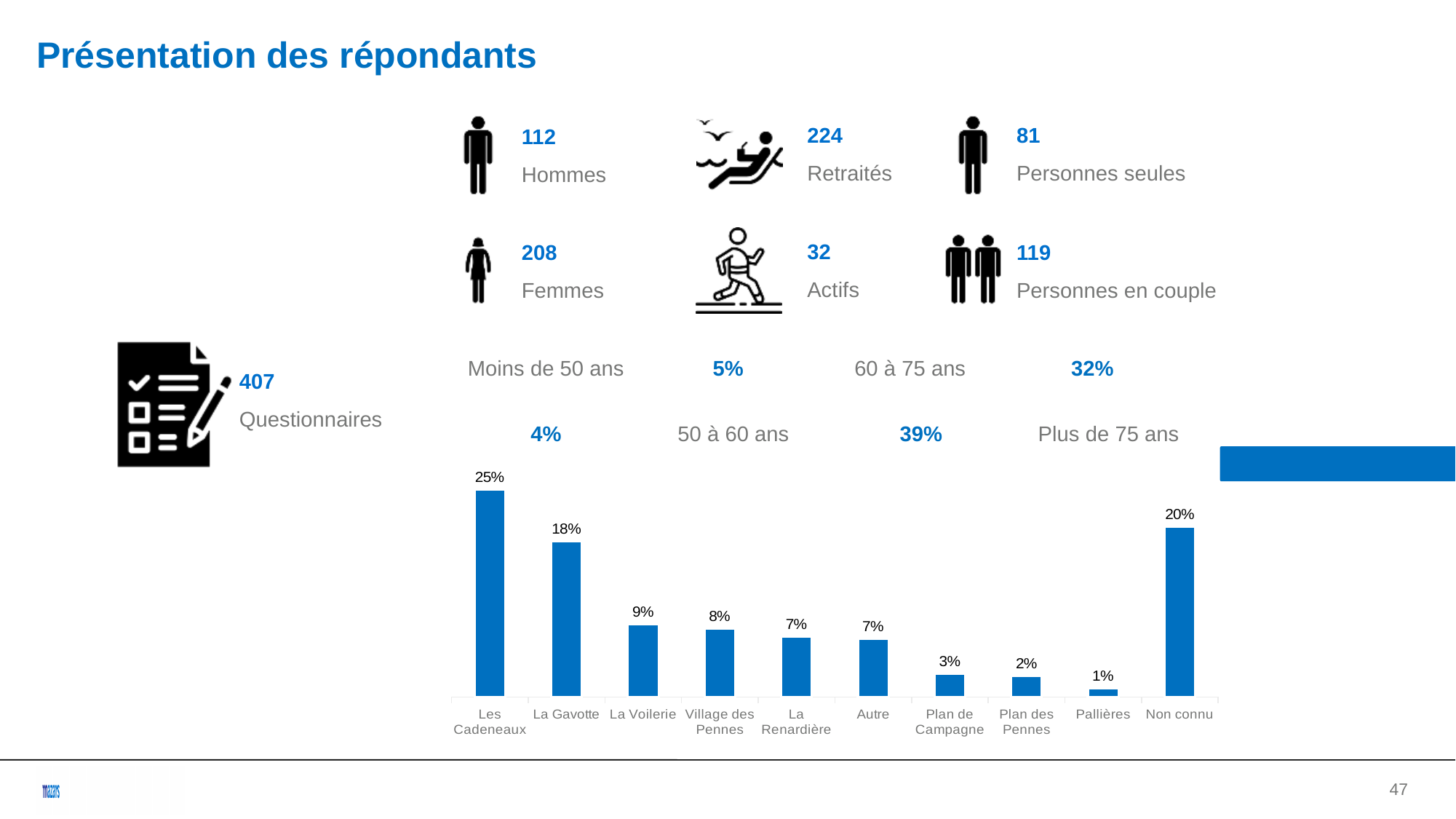
What is the value for La Gavotte in the bar chart? 18% What colour are the bars in the chart? Blue What kind of chart is shown on the slide? Bar chart What is the difference between the values for Non connu and La Voilerie? 11% What is the value for Plan de Campagne in the bar chart? 3% What is the difference between the values for Les Cadeneaux and La Gavotte? 7% Which category has the lowest value in the bar chart? Pallières What is the value for Non connu in the bar chart? 20% What is the value for Les Cadeneaux in the bar chart? 25% Which category has the highest value in the bar chart? Les Cadeneaux Which is larger, the value for La Voilerie or the value for Village des Pennes? La Voilerie How many categories are shown in the bar chart? 10